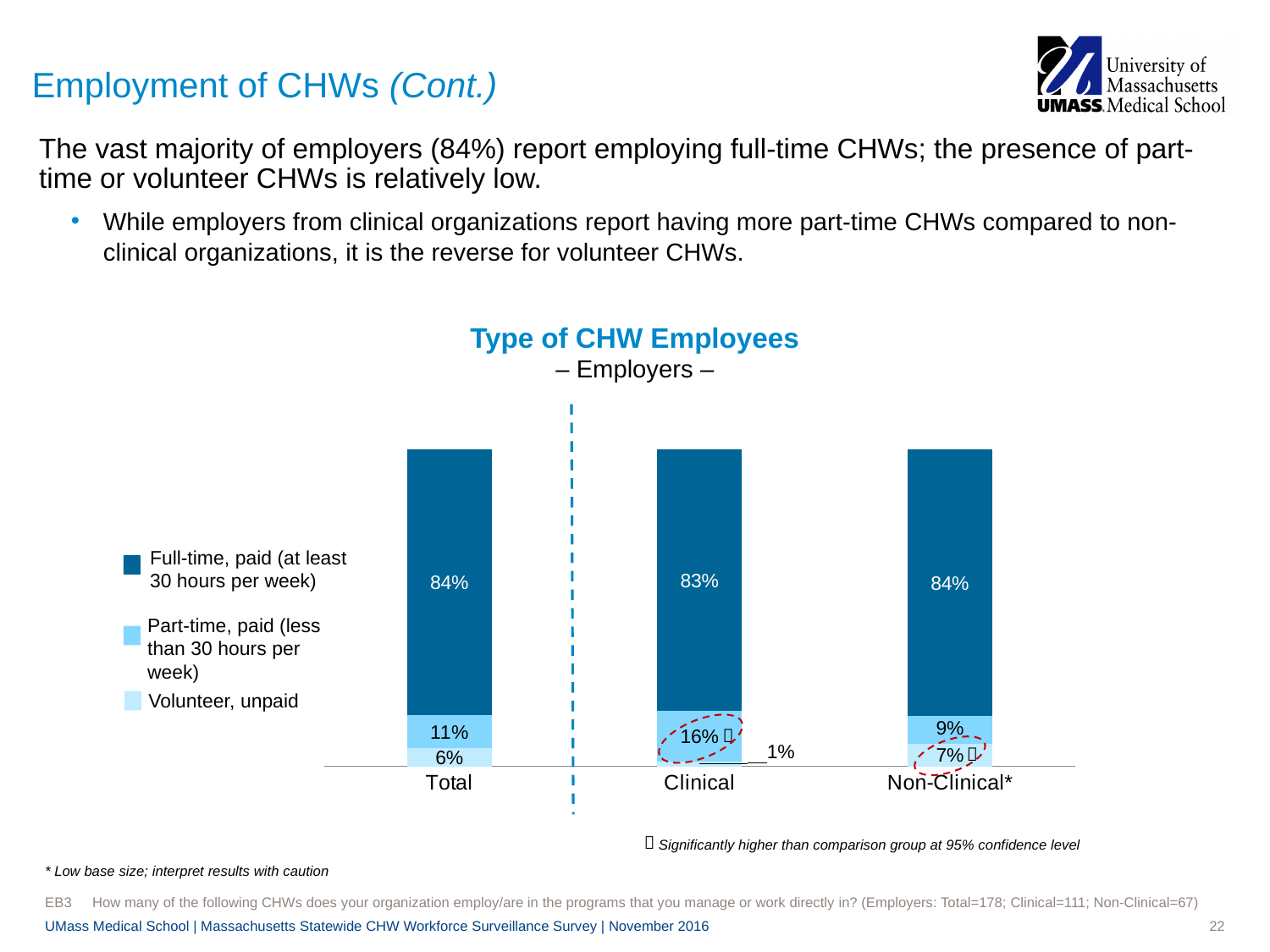
What is the volunteer, unpaid value for Clinical employers? 1% What percentage of Clinical employers report full-time, paid CHWs? 83% Which category has the highest part-time, paid value? Clinical What is the difference between the part-time, paid values for Clinical and Non-Clinical? 7% Which category has the lowest volunteer, unpaid value? Clinical What is the volunteer, unpaid value for Non-Clinical employers? 7% What type of chart is shown on the slide? Stacked bar chart How many categories are shown on the x axis? 3 What is the part-time, paid value for the Total group? 11% Which is larger: the volunteer, unpaid value for Total or for Non-Clinical? Non-Clinical What is the title of the chart? Type of CHW Employees – Employers – How many series does the legend list? 3